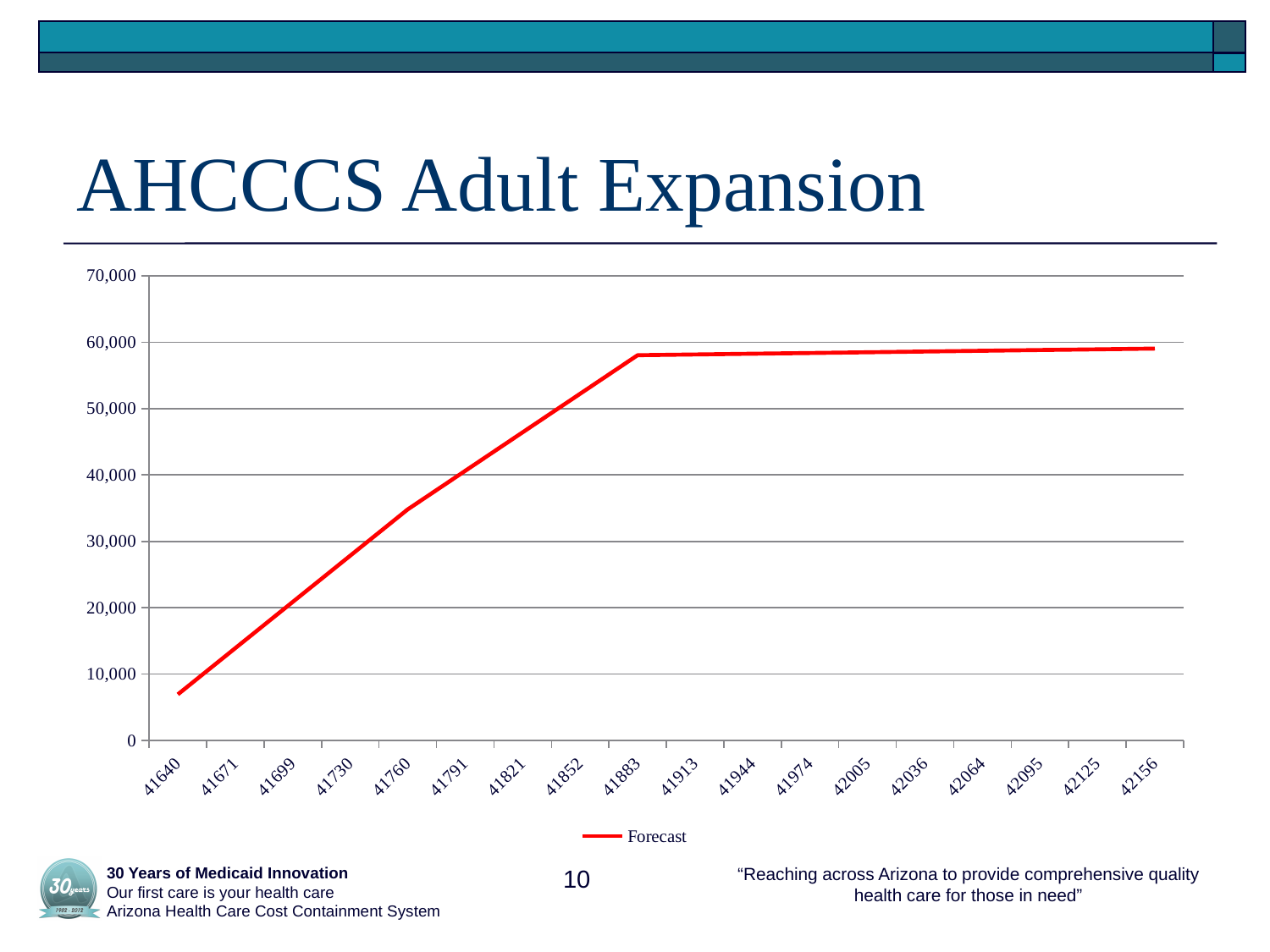
Do the Forecast values rise or fall along the x axis? rise Is the Forecast value at 41760 greater or less than 30,000? greater At which x-axis label is the Forecast value highest? 42156 At which x-axis label is the Forecast value lowest? 41640 How many series does the legend list? 1 Which has the larger Forecast value, 41760 or 41883? 41883 Is the Forecast value at 41883 greater or less than 60,000? less What kind of chart is shown on the slide? line chart How many points are labelled along the x axis? 18 Is the Forecast value at 41640 greater or less than 10,000? less What is the name of the series shown in the legend? Forecast What is the title of the slide containing the chart? AHCCCS Adult Expansion